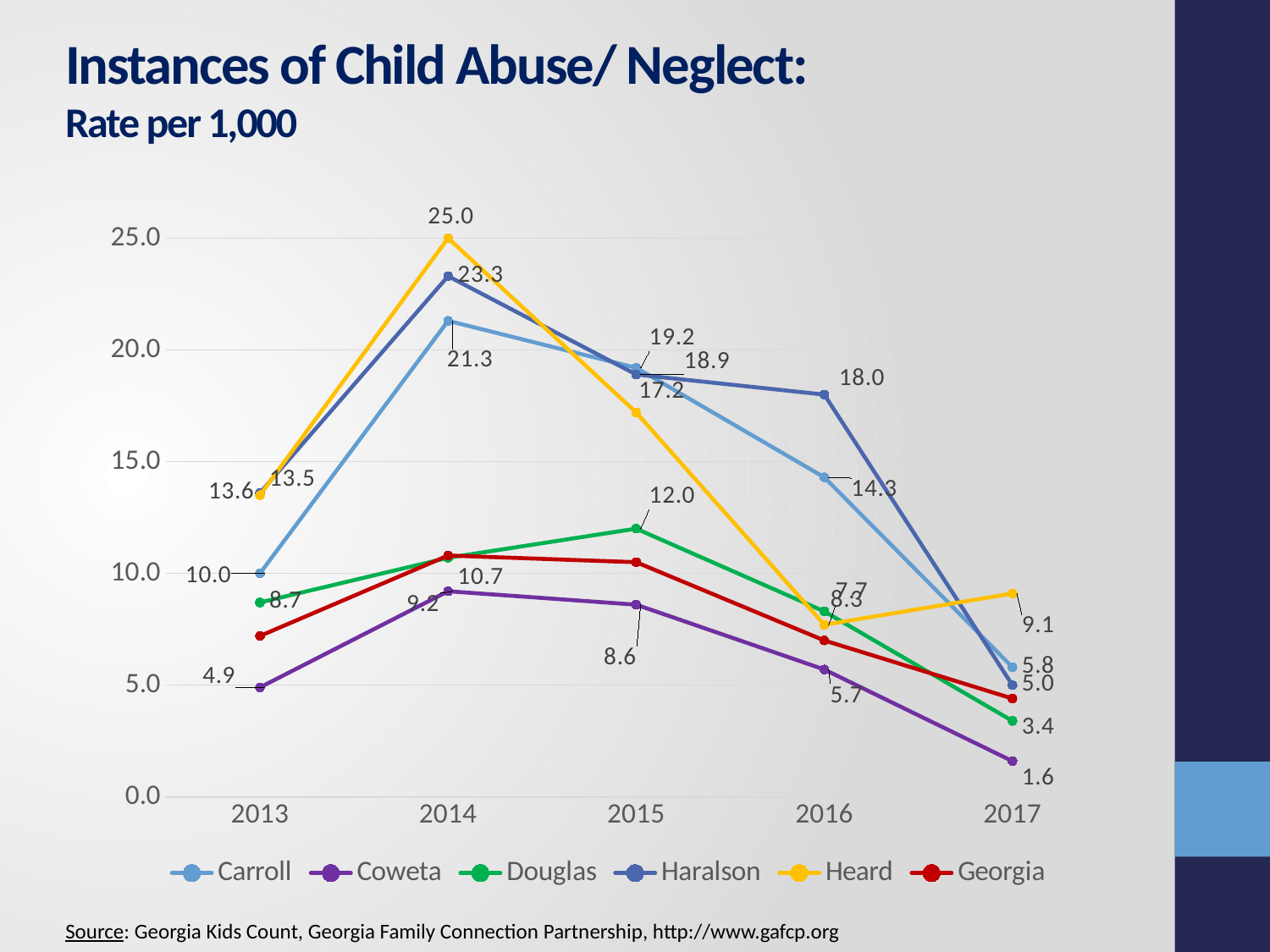
How many years are shown on the x axis? 5 What is the difference between Heard and Haralson in 2014? 1.7 Which county has the lowest value on the chart, and in which year? Coweta, 2017 How many series does the legend list? 6 In 2016, which is larger: Carroll or Haralson? Haralson Which county has the highest value on the chart, and in which year? Heard, 2014 What is the rate for Heard in 2014? 25.0 What is the rate for Douglas in 2015? 12.0 What type of chart is shown on the slide? line chart What is the rate for Coweta in 2017? 1.6 What is the rate for Haralson in 2014? 23.3 Is the value for Georgia in 2013 greater or less than 10.0? less